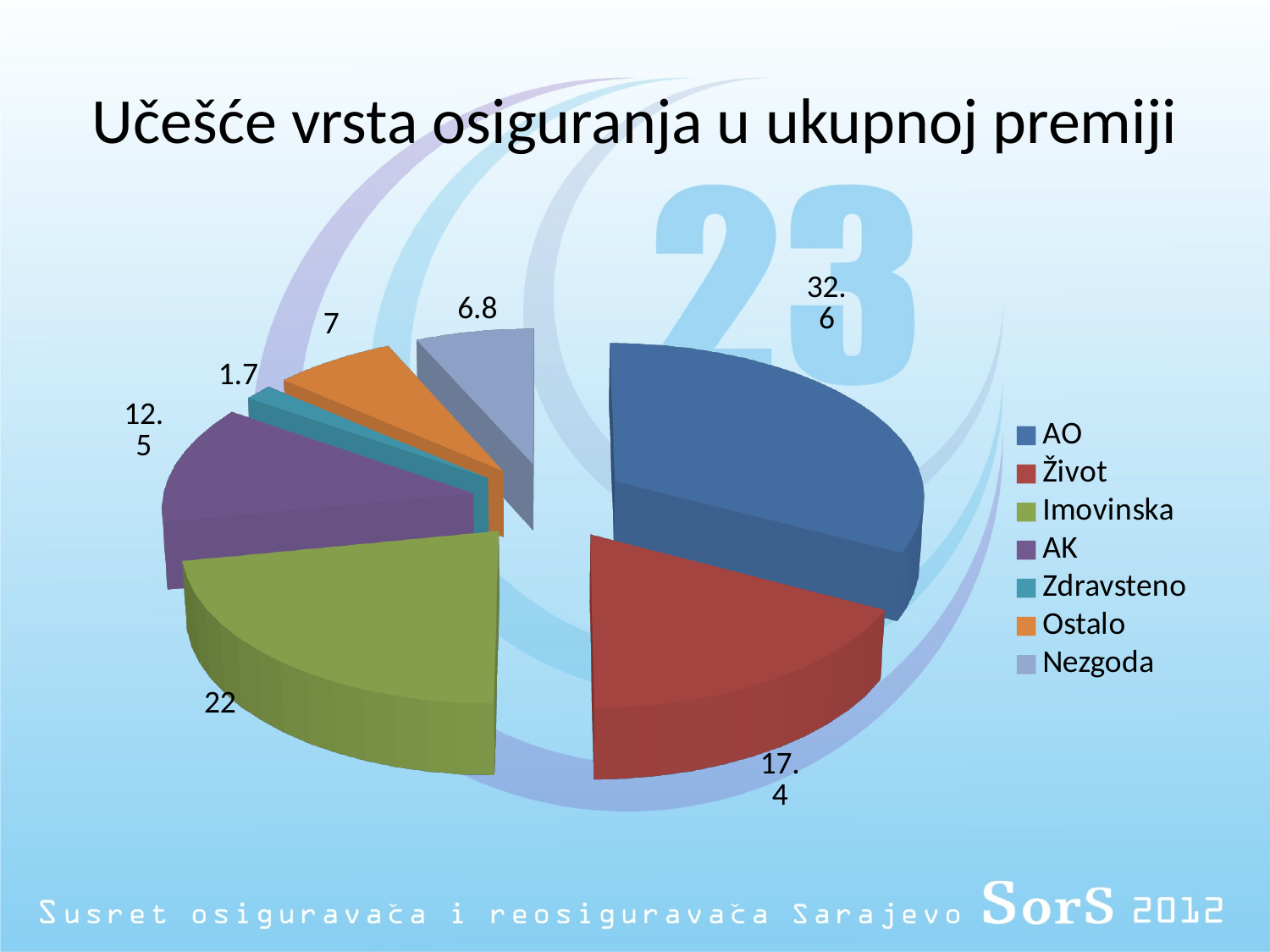
What is the value for Zdravsteno? 1.7 What is the difference between the values for AO and Život? 15.2 What is the value for Imovinska? 22 Which category has the smallest slice? Zdravsteno How many categories does the legend list? 7 Which category has the largest slice? AO What is the value for Život? 17.4 Which is larger, the value for Ostalo or the value for Nezgoda? Ostalo What is the value for AK? 12.5 What kind of chart is shown on the slide? pie chart What is the value for AO? 32.6 What is the title of the chart? Učešće vrsta osiguranja u ukupnoj premiji